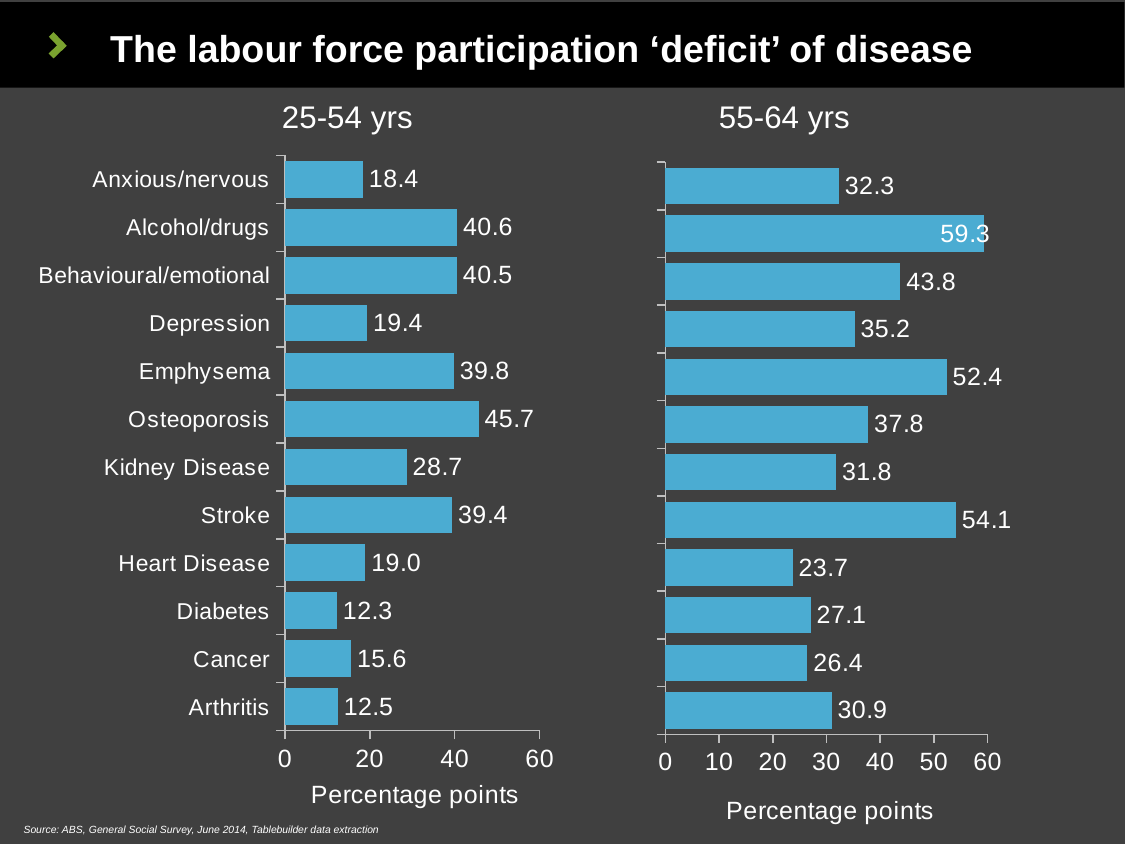
In the 25-54 yrs chart, what is the value for Osteoporosis? 45.7 In the 55-64 yrs chart, which category has the highest value? Alcohol/drugs In the 55-64 yrs chart, what is the value for Stroke? 54.1 In the 55-64 yrs chart, what is the value for Heart Disease? 23.7 In the 55-64 yrs chart, which category has the lowest value? Heart Disease In the 25-54 yrs chart, which category has the highest value? Osteoporosis How many categories are shown in the 25-54 yrs chart? 12 In the 25-54 yrs chart, which is larger: the value for Kidney Disease or the value for Depression? Kidney Disease What is the x-axis label of the 25-54 yrs chart? Percentage points What kind of chart is the 55-64 yrs chart? Bar chart What is the difference between the Stroke value in the 55-64 yrs chart and the Stroke value in the 25-54 yrs chart? 14.7 In the 25-54 yrs chart, which category has the lowest value? Diabetes